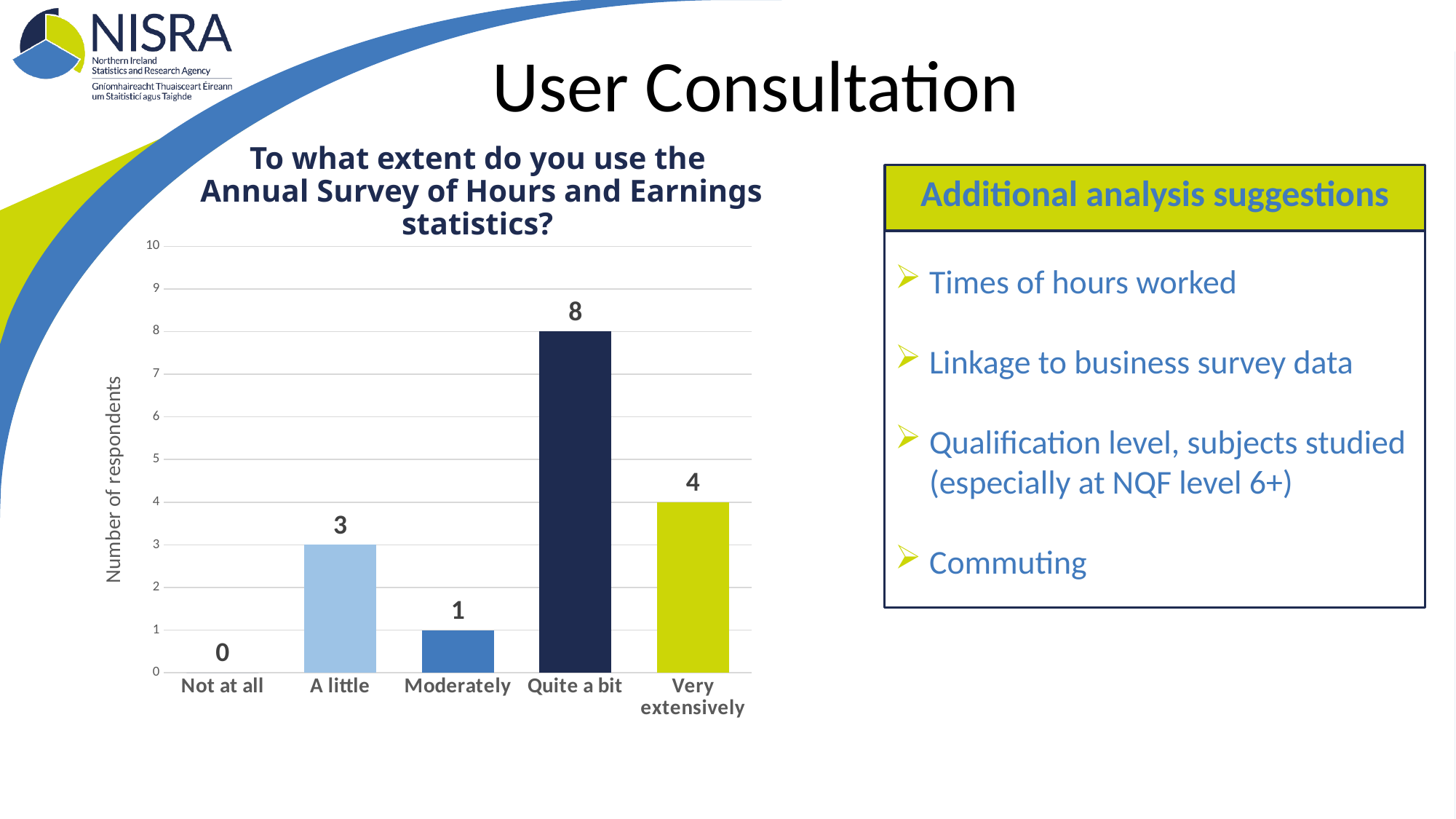
What is the total number of respondents across all categories? 16 Which has more respondents, 'A little' or 'Moderately'? A little How many respondents answered 'Quite a bit'? 8 What is the difference in respondents between 'Quite a bit' and 'Very extensively'? 4 How many respondents answered 'Not at all'? 0 Which category has the lowest number of respondents? Not at all How many respondents answered 'Very extensively'? 4 What is the label of the vertical axis? Number of respondents What kind of chart is shown on the slide? Bar chart How many respondents answered 'A little'? 3 Which category has the highest number of respondents? Quite a bit How many categories are shown on the x axis? 5